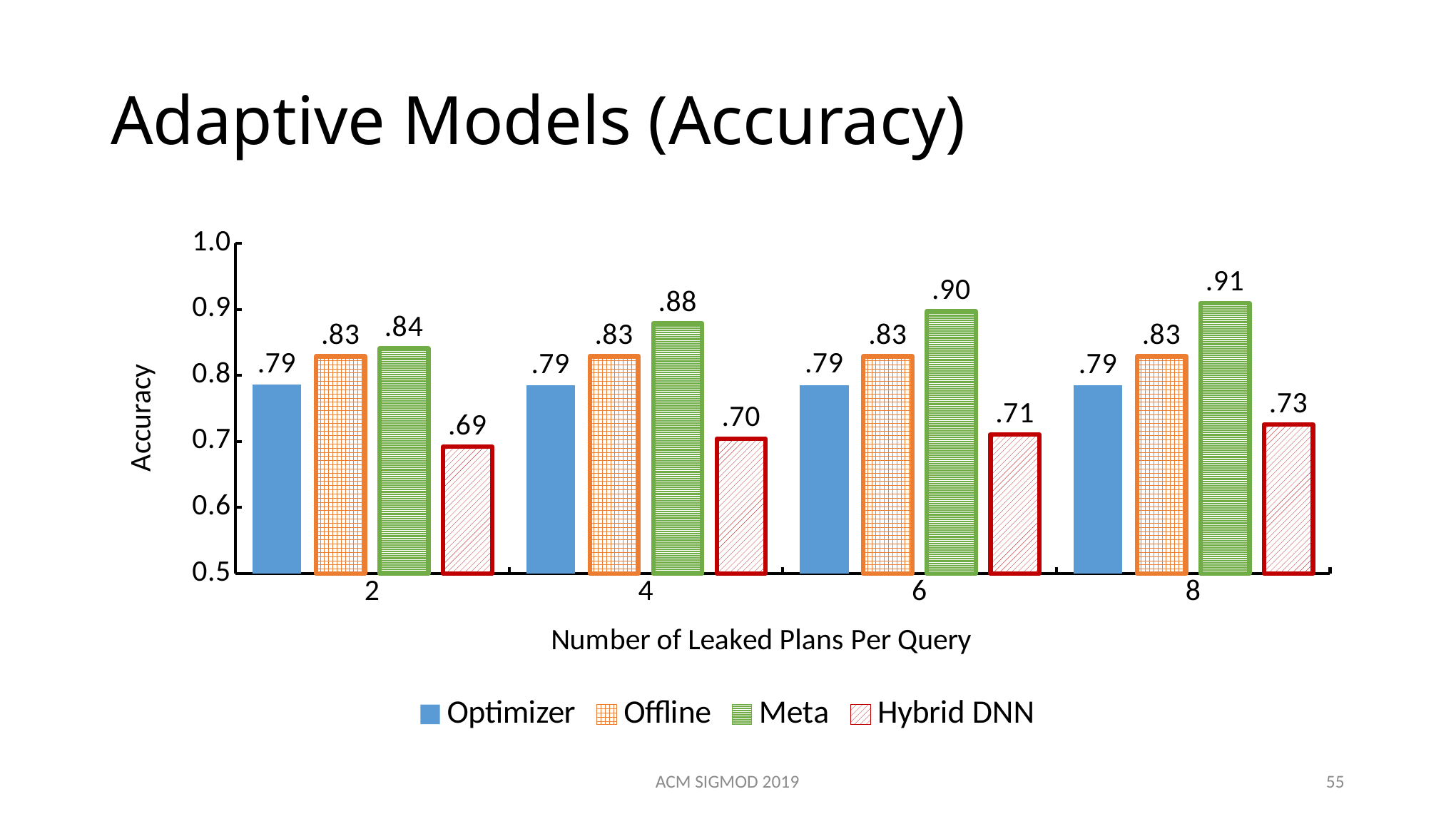
What is the accuracy of Hybrid DNN at 8 leaked plans per query? .73 Which series has the lowest accuracy at 2 leaked plans per query? Hybrid DNN What is the accuracy of Offline at 6 leaked plans per query? .83 Which series has the highest accuracy at 8 leaked plans per query? Meta What is the label of the y axis? Accuracy Does the Meta accuracy rise or fall as the number of leaked plans per query increases? Rises Which is larger: the Optimizer accuracy at 4 leaked plans or the Hybrid DNN accuracy at 4 leaked plans? Optimizer How many series does the legend list? 4 What kind of chart is shown on the slide? Bar chart How many categories are shown on the x axis? 4 What is the accuracy of Meta at 4 leaked plans per query? .88 What is the difference between the Meta and Hybrid DNN accuracy at 6 leaked plans per query? .19